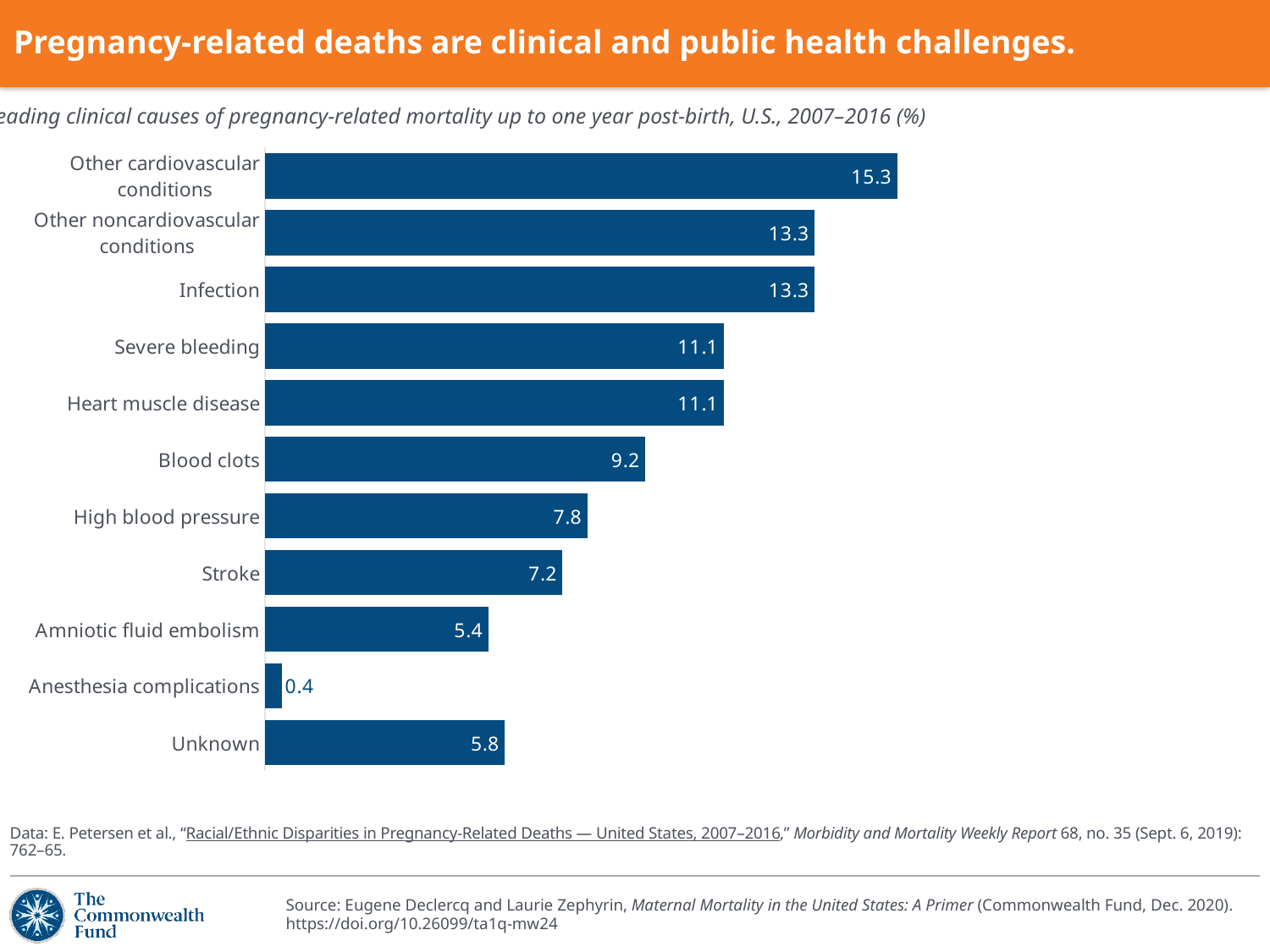
What is the difference between the values for Blood clots and High blood pressure? 1.4 What is the difference between the values for Other cardiovascular conditions and Anesthesia complications? 14.9 Which is larger, the value for Infection or the value for Severe bleeding? Infection What is the value for Other cardiovascular conditions? 15.3 Which category has the highest value? Other cardiovascular conditions What is the value for Unknown? 5.8 Which category has the lowest value? Anesthesia complications How many categories are shown in the chart? 11 What is the value for Anesthesia complications? 0.4 Which is larger, the value for Unknown or the value for Amniotic fluid embolism? Unknown What is the value for Blood clots? 9.2 What kind of chart is shown on the slide? Bar chart